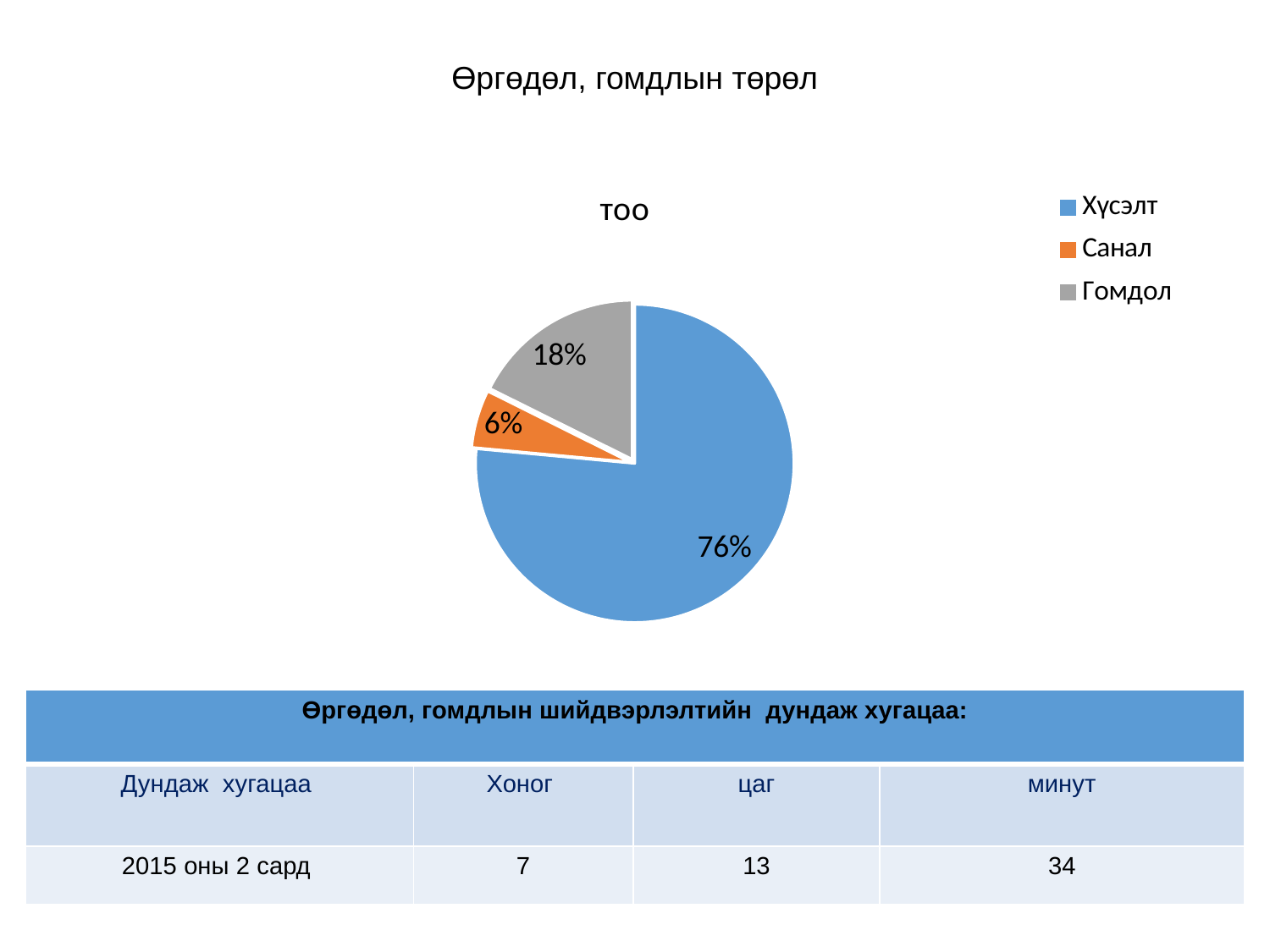
What colour is the Санал slice? orange Which is larger, the share for Гомдол or the share for Санал? Гомдол What share of the pie does Гомдол have? 18% Which category has the smallest slice of the pie? Санал What share of the pie does Санал have? 6% What kind of chart is shown on the slide? pie chart What share of the pie does Хүсэлт have? 76% How many categories does the pie chart show? 3 What is the title of the chart? тоо What is the difference in percentage points between the Хүсэлт share and the Гомдол share? 58 How many entries does the legend list? 3 Which category has the largest slice of the pie? Хүсэлт